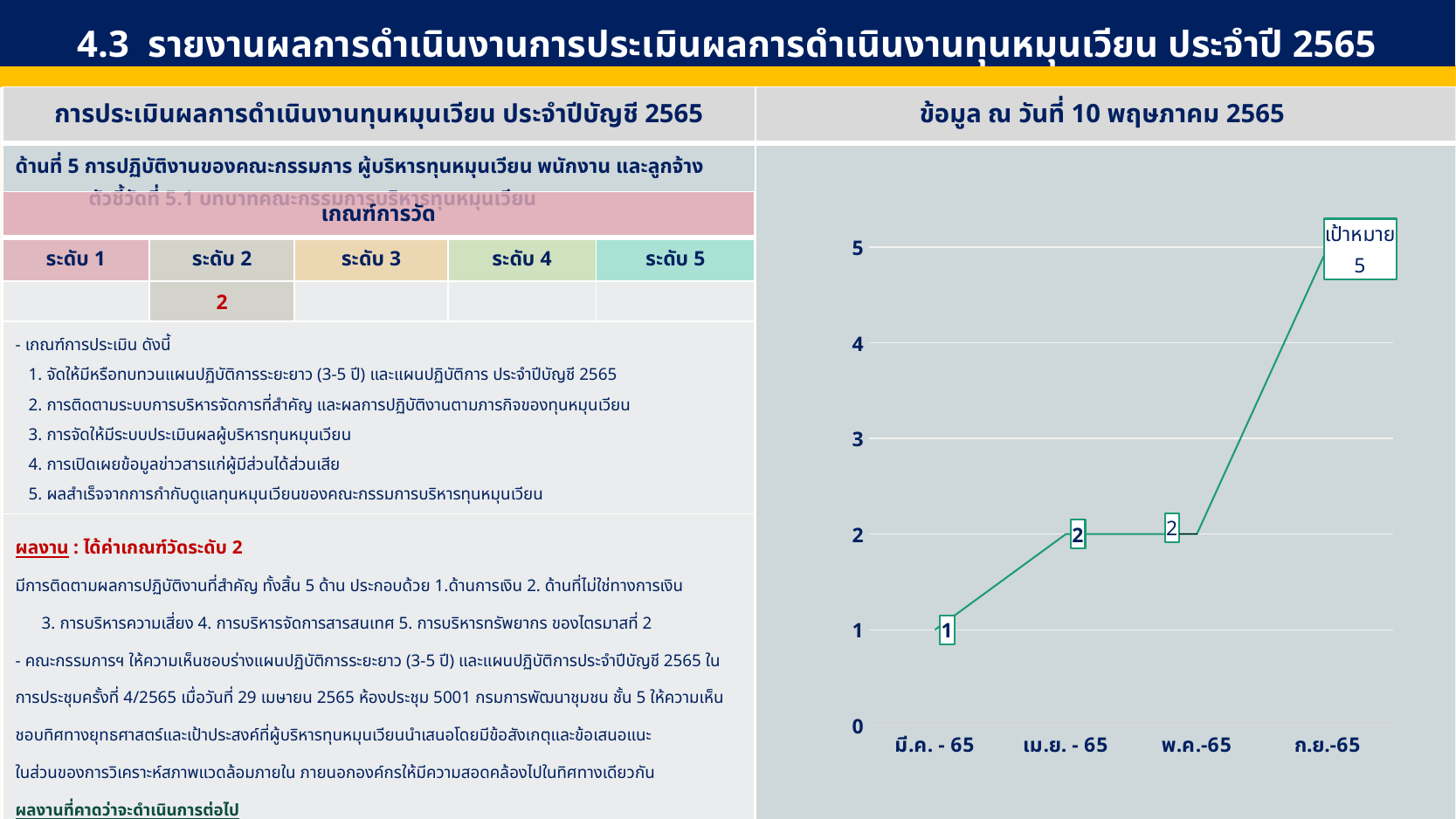
What is the value for ก.ย.-65 in the line chart? 5 What is the difference between the values for ก.ย.-65 and พ.ค.-65 in the line chart? 3 What is the value for เม.ย. - 65 in the line chart? 2 What is the value for พ.ค.-65 in the line chart? 2 Which is larger in the line chart, the value for เม.ย. - 65 or the value for มี.ค. - 65? เม.ย. - 65 Do the values in the line chart rise or fall from มี.ค. - 65 to ก.ย.-65? rise What label is attached to the last point of the line chart? เป้าหมาย 5 What is the value for มี.ค. - 65 in the line chart? 1 How many data points are plotted in the line chart? 4 What kind of chart is shown on the right side of the slide? line chart Which category has the lowest value in the line chart? มี.ค. - 65 Which category has the highest value in the line chart? ก.ย.-65